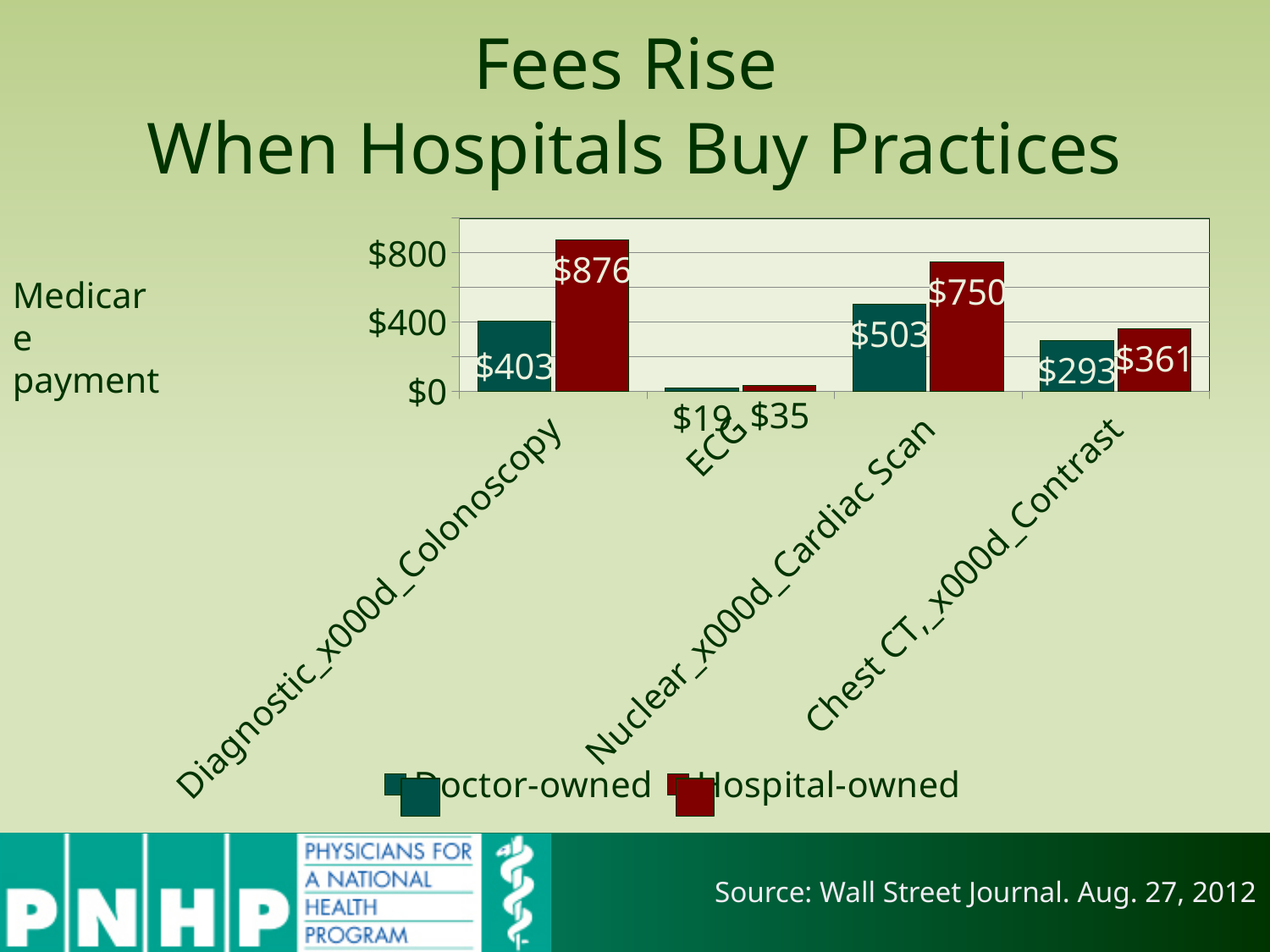
Which category has the lowest Doctor-owned payment? ECG How many series does the legend list? 2 What is the difference between the Hospital-owned and Doctor-owned payments for Diagnostic Colonoscopy? $473 Which is larger for Chest CT with Contrast: the Doctor-owned or the Hospital-owned payment? Hospital-owned What is the Hospital-owned Medicare payment for Chest CT with Contrast? $361 What kind of chart is shown on the slide? Bar chart What is the Hospital-owned Medicare payment for Diagnostic Colonoscopy? $876 What is the Hospital-owned Medicare payment for ECG? $35 Which category has the highest Hospital-owned payment? Diagnostic Colonoscopy What is the Doctor-owned Medicare payment for Diagnostic Colonoscopy? $403 What is the difference between the Hospital-owned and Doctor-owned payments for Nuclear Cardiac Scan? $247 What is the Doctor-owned Medicare payment for Nuclear Cardiac Scan? $503